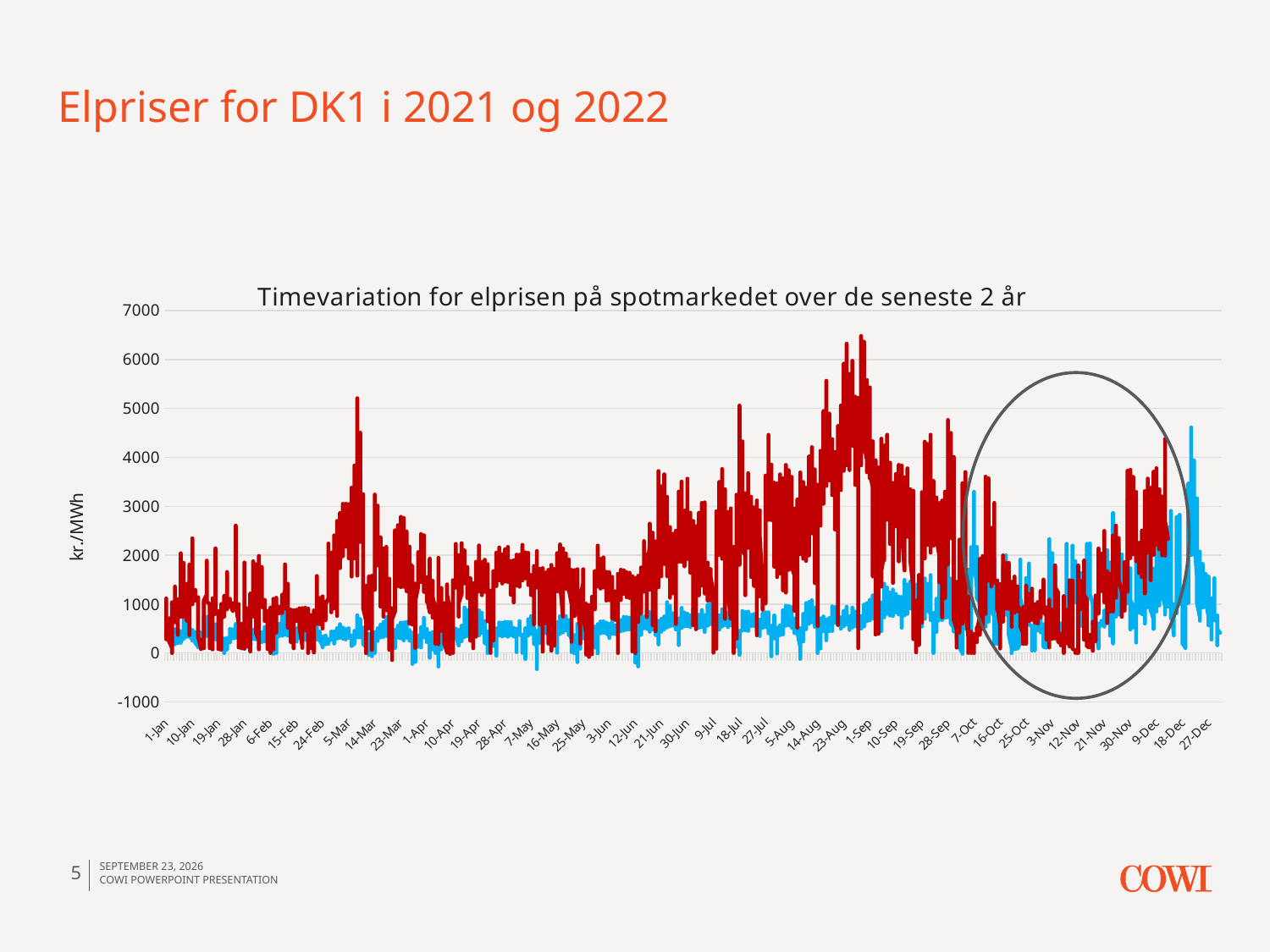
Is the highest peak of the red series (around 1-Sep) greater or less than 6000? greater Around 1-Sep, which series has the higher values, red or blue? red Which series reaches the higher maximum value, the red series or the blue series? the red series What is the title of the chart? Timevariation for elprisen på spotmarkedet over de seneste 2 år Is the blue series around 1-Jan greater or less than 1000? less What kind of chart is shown on the slide? line chart Is the red series peak around 5-Mar greater or less than 4000? greater Does the blue series generally rise or fall from 1-Jan to 18-Dec? rise What is the label on the vertical axis of the chart? kr./MWh